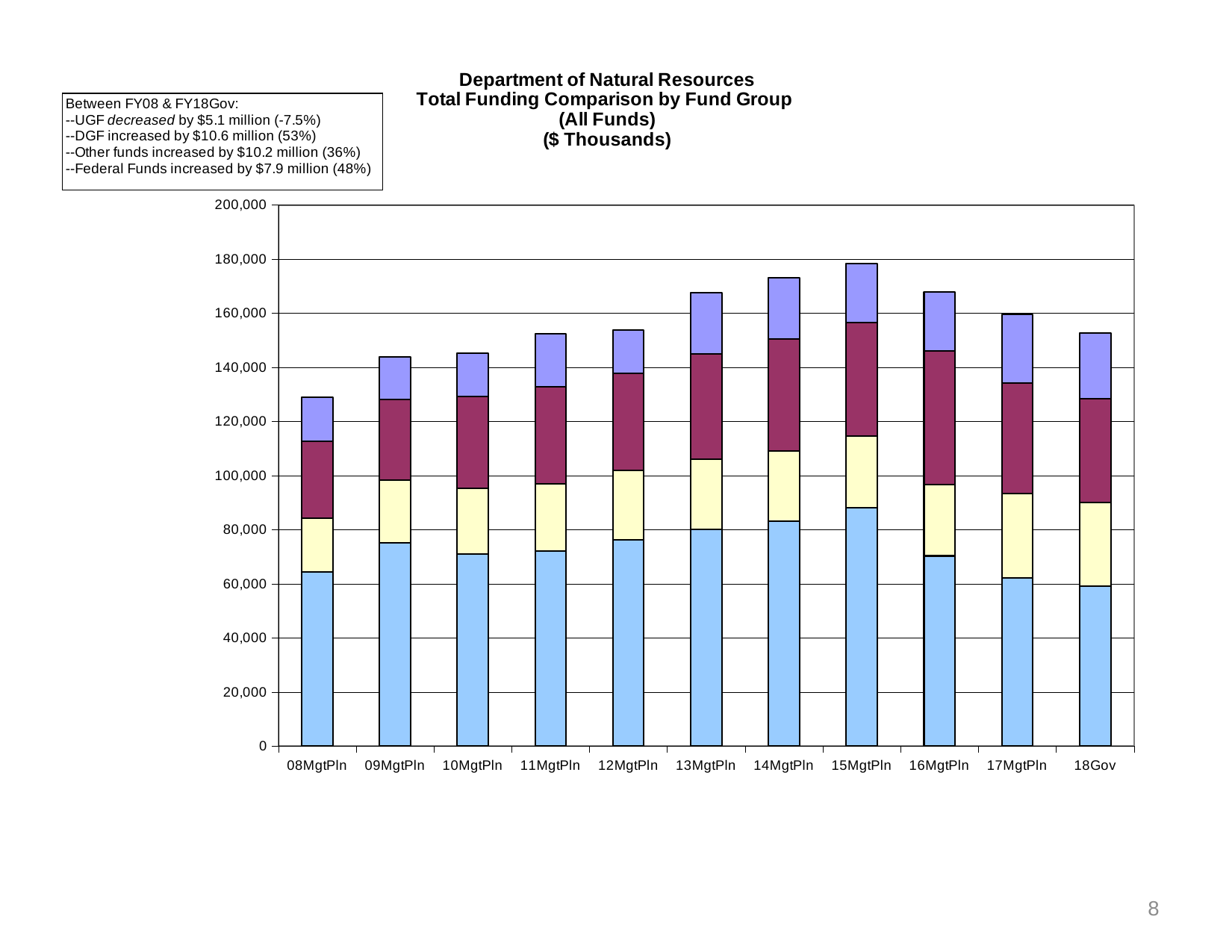
Which category has the shortest stacked bar (lowest total funding)? 08MgtPln How many coloured segments make up each stacked bar? 4 Which category has the tallest stacked bar (highest total funding)? 15MgtPln What kind of chart is shown on the slide? stacked bar chart Do the bar totals rise or fall from 15MgtPln to 18Gov? fall Is the bottom (light blue) segment for 17MgtPln greater or less than 80,000? less Is the total for 08MgtPln greater or less than 140,000? less Is the total for 18Gov greater or less than 140,000? greater Which has the larger total, 13MgtPln or 14MgtPln? 14MgtPln How many categories are shown along the x axis of the chart? 11 What is the title of the chart? Department of Natural Resources Total Funding Comparison by Fund Group (All Funds) ($ Thousands)